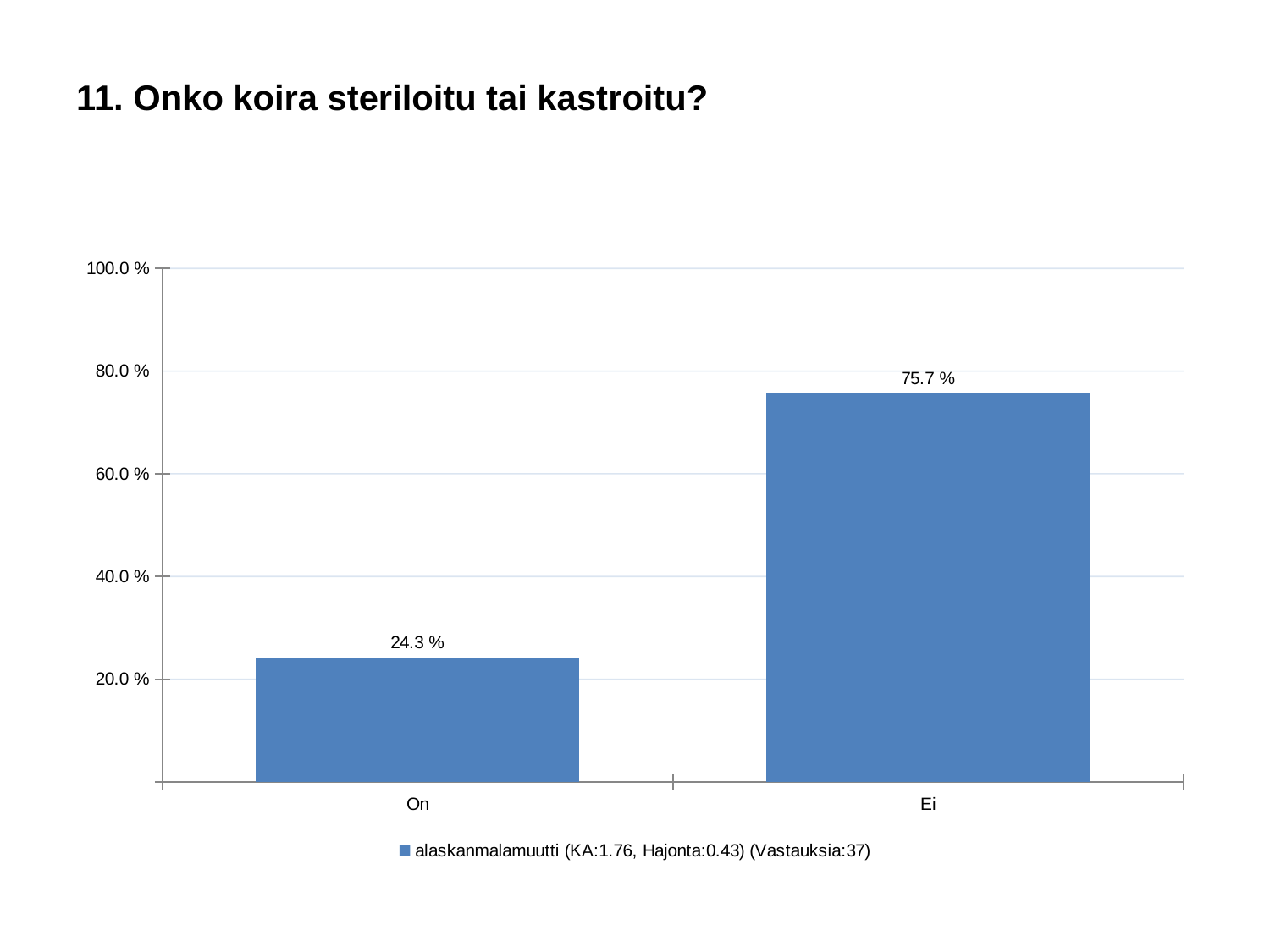
What kind of chart is shown on the slide? bar chart How many categories are shown on the x axis? 2 What is the value for "On"? 24.3 % How many series does the legend list? 1 What is the value for "Ei"? 75.7 % Is the value for "Ei" greater or less than 60.0 %? greater Is the value for "On" greater or less than 40.0 %? less Which is larger, the value for "On" or the value for "Ei"? Ei What is the title of the slide? 11. Onko koira steriloitu tai kastroitu? Which category has the highest value? Ei Which category has the lowest value? On What is the difference between the values for "Ei" and "On"? 51.4 %